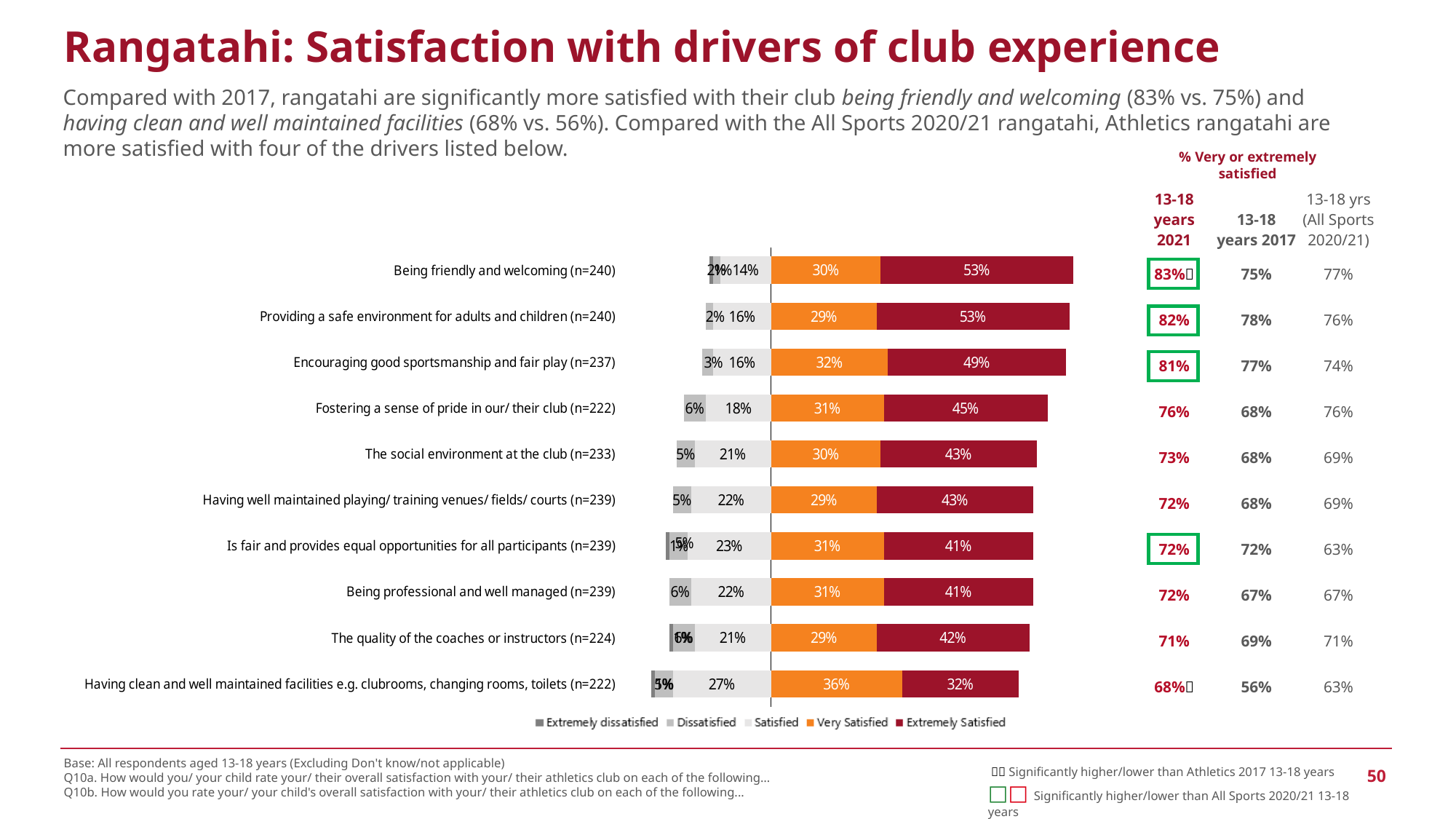
What is the combined Very Satisfied and Extremely Satisfied value for 'Fostering a sense of pride in our/ their club (n=222)'? 76% What kind of chart is shown on the slide? Stacked bar chart How many series does the chart legend list? 5 Which driver has the highest Very Satisfied value? Having clean and well maintained facilities e.g. clubrooms, changing rooms, toilets (n=222) What is the Extremely Satisfied value for 'Being friendly and welcoming (n=240)'? 53% Which driver has the lowest Extremely Satisfied value? Having clean and well maintained facilities e.g. clubrooms, changing rooms, toilets (n=222) What is the Very Satisfied value for 'Having clean and well maintained facilities e.g. clubrooms, changing rooms, toilets (n=222)'? 36% What is the Satisfied value for 'Fostering a sense of pride in our/ their club (n=222)'? 18% How many drivers (categories) are plotted in the chart? 10 Which has a larger Extremely Satisfied value: 'Fostering a sense of pride in our/ their club (n=222)' or 'The social environment at the club (n=233)'? Fostering a sense of pride in our/ their club (n=222) For 'Encouraging good sportsmanship and fair play (n=237)', how much larger is the Extremely Satisfied value than the Very Satisfied value? 17 percentage points Which colour represents the Extremely Satisfied series in the chart? Dark red